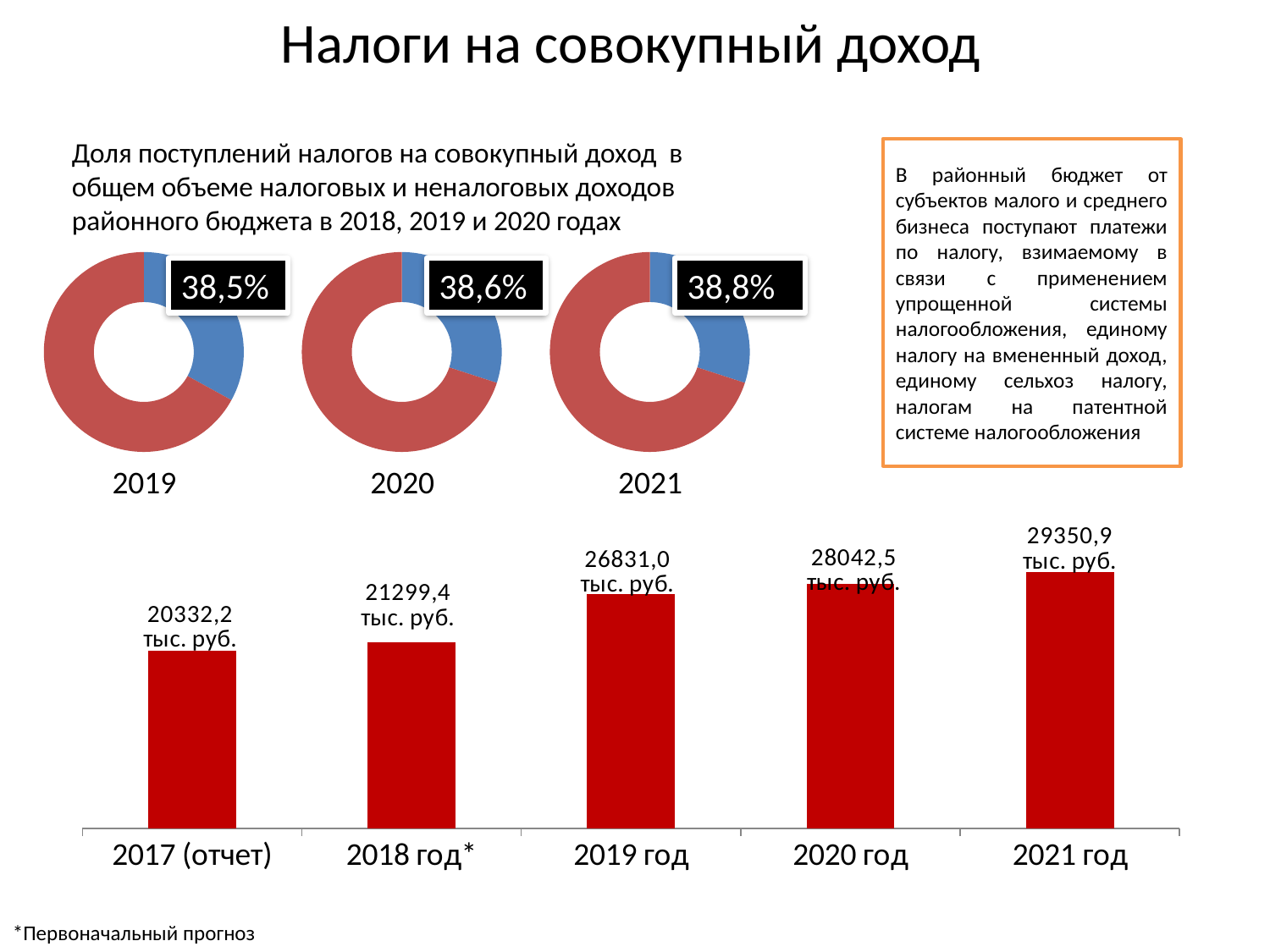
In the bar chart at the bottom of the slide, which is larger: the value for 2018 год* or the value for 2019 год? 2019 год In the bar chart at the bottom of the slide, what is the value for 2019 год? 26831,0 тыс. руб. How many bars are in the bar chart at the bottom of the slide? 5 In the bar chart at the bottom of the slide, what is the difference between the values for 2021 год and 2020 год? 1308,4 тыс. руб. In the bar chart at the bottom of the slide, which category has the lowest value? 2017 (отчет) In the bar chart at the bottom of the slide, do the values rise or fall from 2017 (отчет) to 2021 год? Rise What kind of chart is shown at the bottom of the slide? Bar chart In the bar chart at the bottom of the slide, what is the value for 2017 (отчет)? 20332,2 тыс. руб. What percentage is shown on the donut chart labelled 2020? 38,6% How many donut charts are shown in the upper part of the slide? 3 In the bar chart at the bottom of the slide, which category has the highest value? 2021 год In the bar chart at the bottom of the slide, what is the value for 2021 год? 29350,9 тыс. руб.